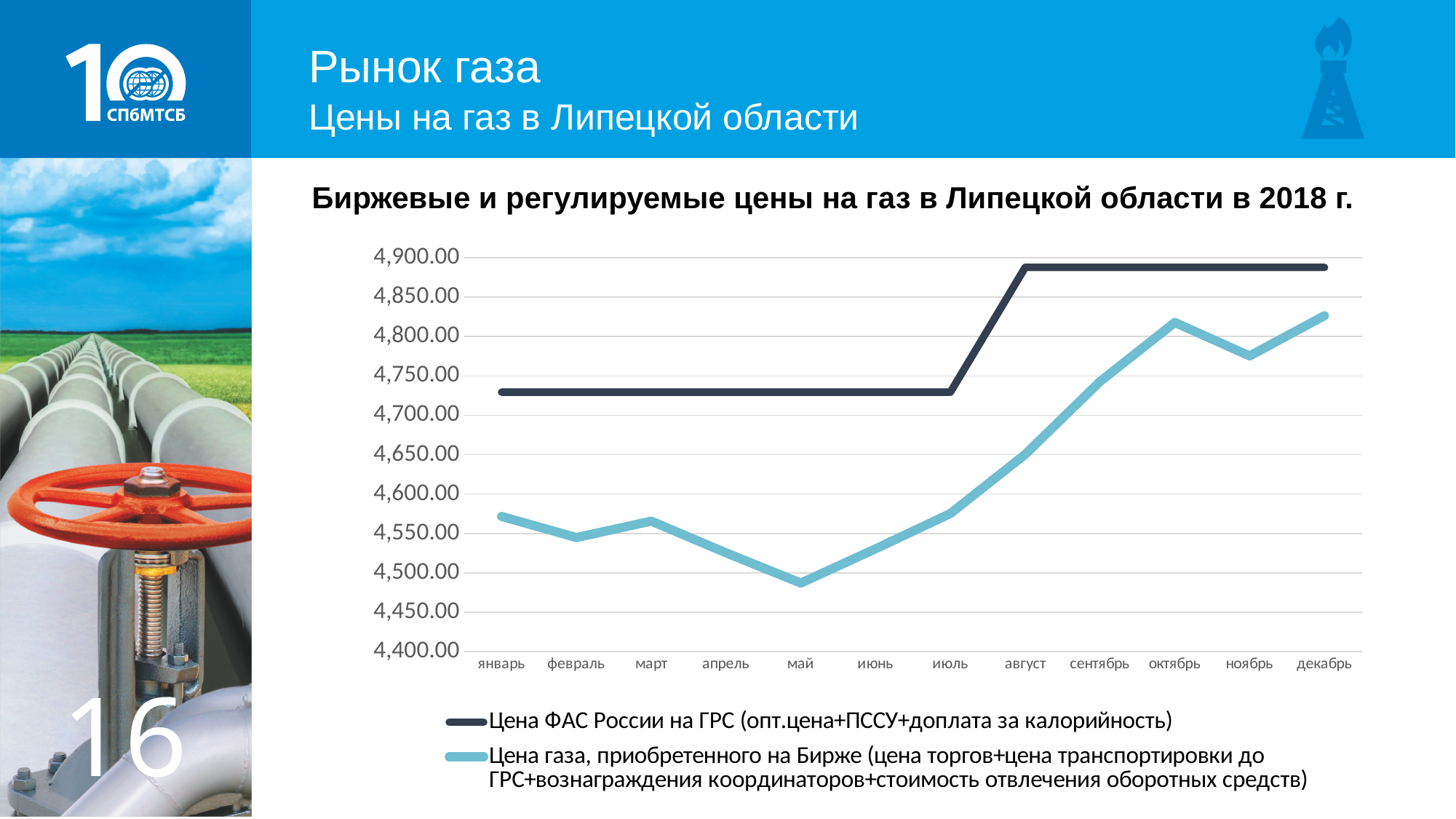
How many series does the legend list? 2 How many months are plotted along the x axis? 12 In January, which is higher: the FAS price or the exchange gas price? the FAS price (Цена ФАС России на ГРС) What kind of chart is shown on the slide? line chart In which month is the exchange gas price (Цена газа, приобретенного на Бирже) lowest? май Does the exchange gas price rise or fall from May to October? rise Is the exchange gas price in August greater or less than 4,600.00? greater Is the FAS price (Цена ФАС России на ГРС) in January greater or less than 4,750.00? less Is the exchange gas price in May greater or less than 4,500.00? less Which colour is used for the FAS price line (Цена ФАС России на ГРС)? dark navy